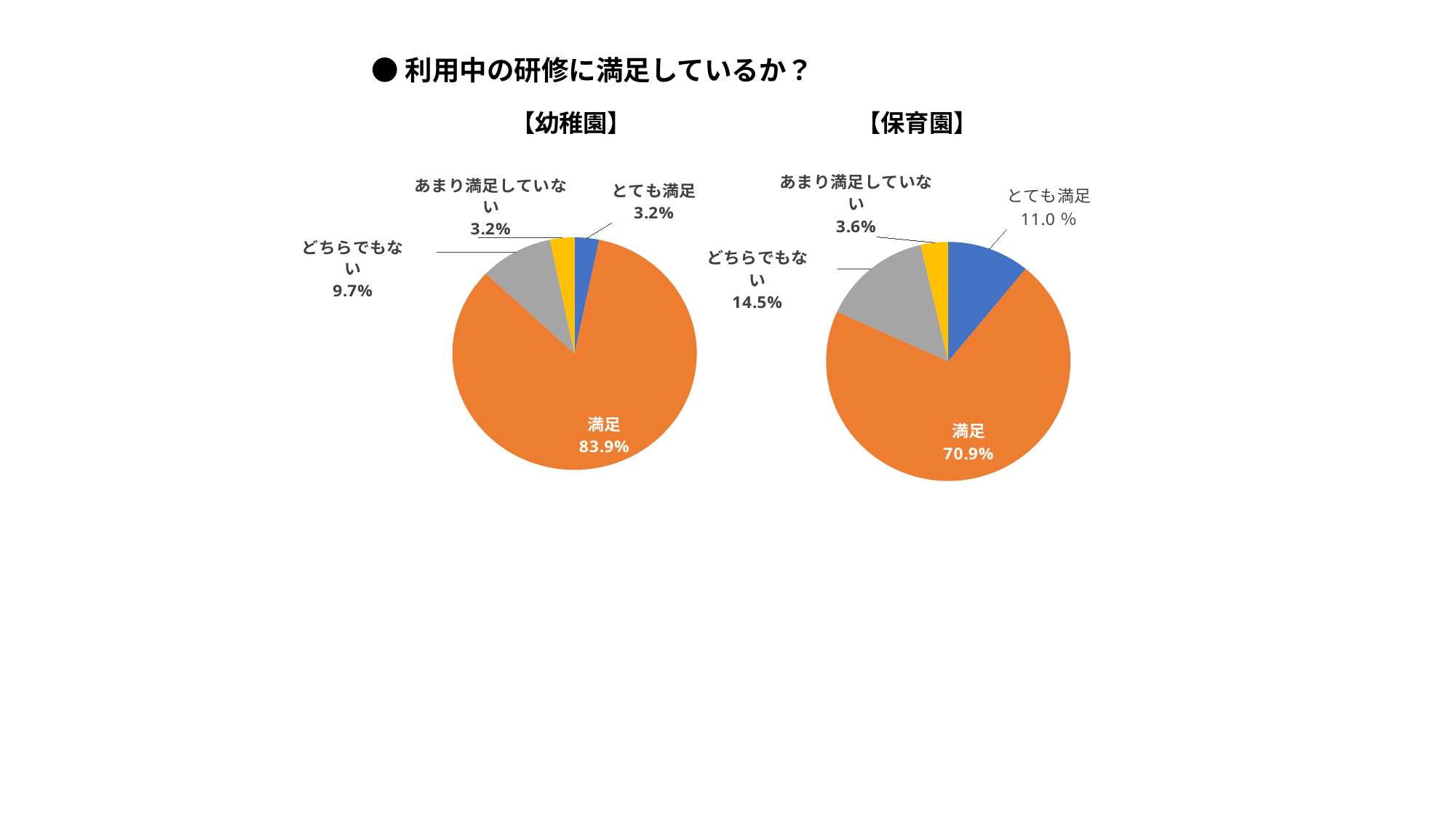
In the 【保育園】 chart, what percentage is shown for あまり満足していない? 3.6% In the 【保育園】 chart, what percentage is shown for 満足? 70.9% How many categories does the 【幼稚園】 chart show? 4 In the 【幼稚園】 chart, which category has the largest share? 満足 Which chart shows a larger share for どちらでもない, 【幼稚園】 or 【保育園】? 【保育園】 In the 【幼稚園】 chart, what percentage is shown for 満足? 83.9% In the 【幼稚園】 chart, what percentage is shown for どちらでもない? 9.7% In the 【保育園】 chart, what percentage is shown for とても満足? 11.0 % What type of chart is used for 【保育園】? Pie chart In the 【保育園】 chart, which category has the smallest share? あまり満足していない What is the difference between the 満足 share in the 【幼稚園】 chart and the 満足 share in the 【保育園】 chart? 13.0% What colour is the 満足 slice in both charts? Orange